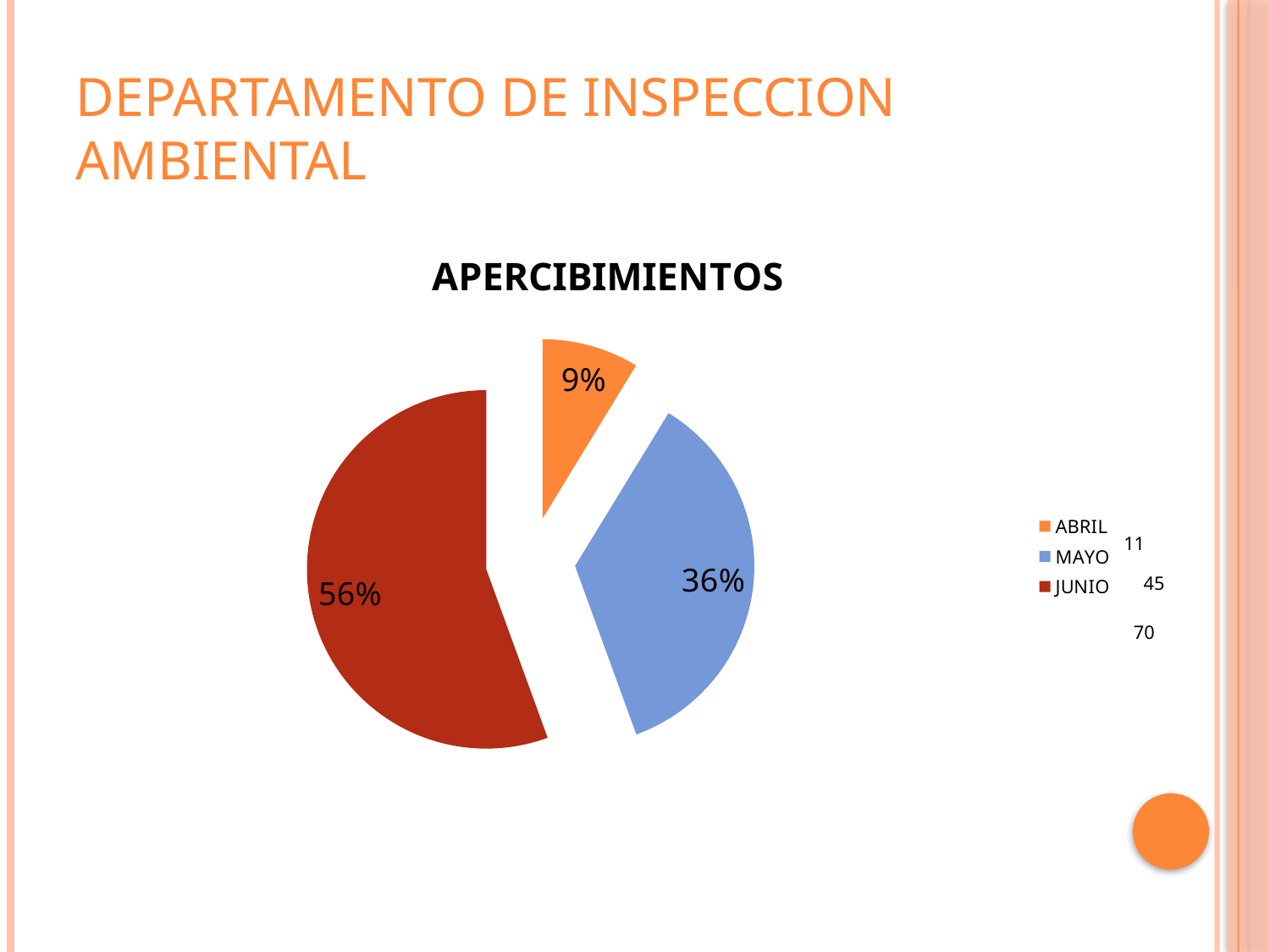
Which slice is larger, MAYO or ABRIL? MAYO What colour is the JUNIO slice? red How many slices does the pie chart have? 3 What is the difference in percentage points between the JUNIO and MAYO slices? 20 percentage points What percentage of the pie does ABRIL represent? 9% What percentage of the pie does MAYO represent? 36% What percentage of the pie does JUNIO represent? 56% What type of chart is shown on the slide? pie chart What is the title of the chart? APERCIBIMIENTOS How many entries does the legend list? 3 Which month has the largest slice of the pie? JUNIO Which month has the smallest slice of the pie? ABRIL